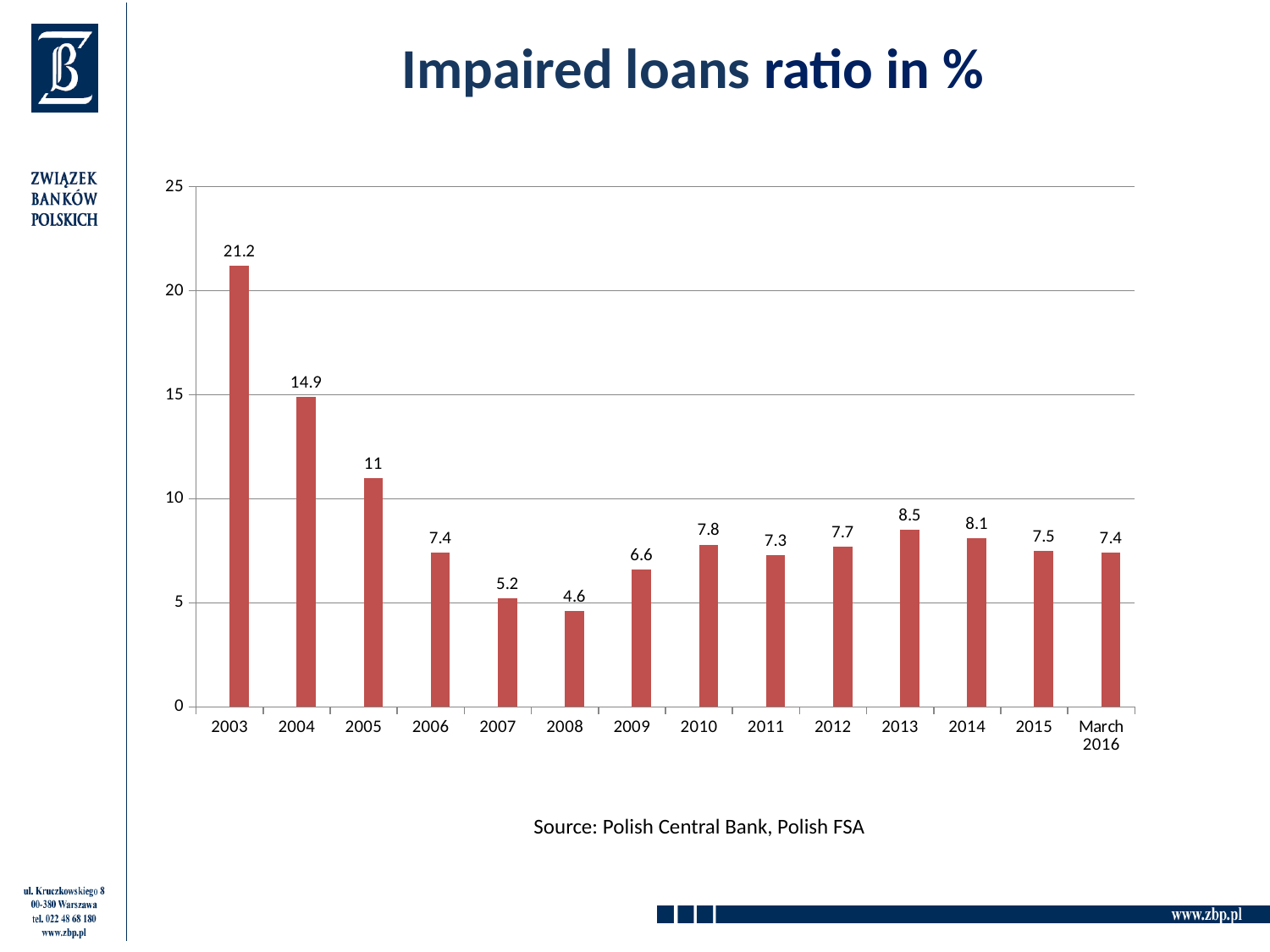
Which year has the lowest impaired loans ratio? 2008 What is the difference between the impaired loans ratio in 2013 and in 2008? 3.9 Does the impaired loans ratio rise or fall from 2003 to 2008? fall What is the difference between the impaired loans ratio in 2003 and in 2004? 6.3 Is the impaired loans ratio for 2004 greater or less than 10? greater What is the impaired loans ratio for March 2016? 7.4 What kind of chart is shown on the slide? bar chart What is the impaired loans ratio for 2003? 21.2 How many periods are shown on the x axis of the chart? 14 Which year has the highest impaired loans ratio? 2003 Which is larger, the impaired loans ratio in 2005 or in 2010? 2005 What is the impaired loans ratio for 2008? 4.6